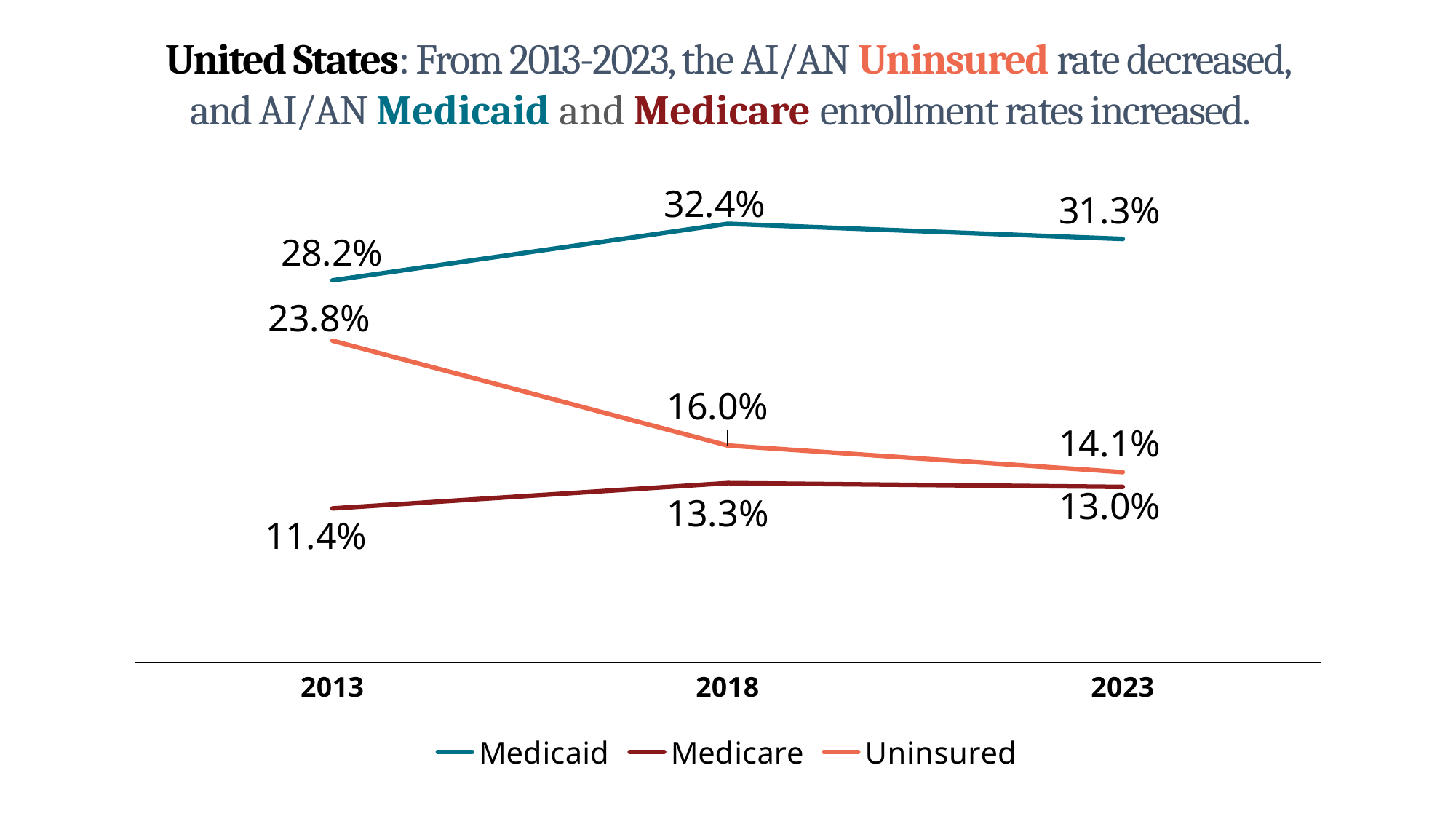
What was the AI/AN Medicaid enrollment rate in 2013? 28.2% What was the AI/AN Medicare enrollment rate in 2023? 13.0% What was the AI/AN Uninsured rate in 2018? 16.0% In which year was the Medicaid enrollment rate highest? 2018 Which series is drawn in the orange line? Uninsured How many years are shown on the x axis? 3 What kind of chart is shown on the slide? Line chart How many series does the legend list? 3 By how many percentage points did the Uninsured rate fall from 2013 to 2023? 9.7 Which was higher in 2013, the Medicare rate or the Uninsured rate? Uninsured Does the Medicare enrollment rate rise or fall from 2013 to 2018? Rise In which year was the Uninsured rate lowest? 2023